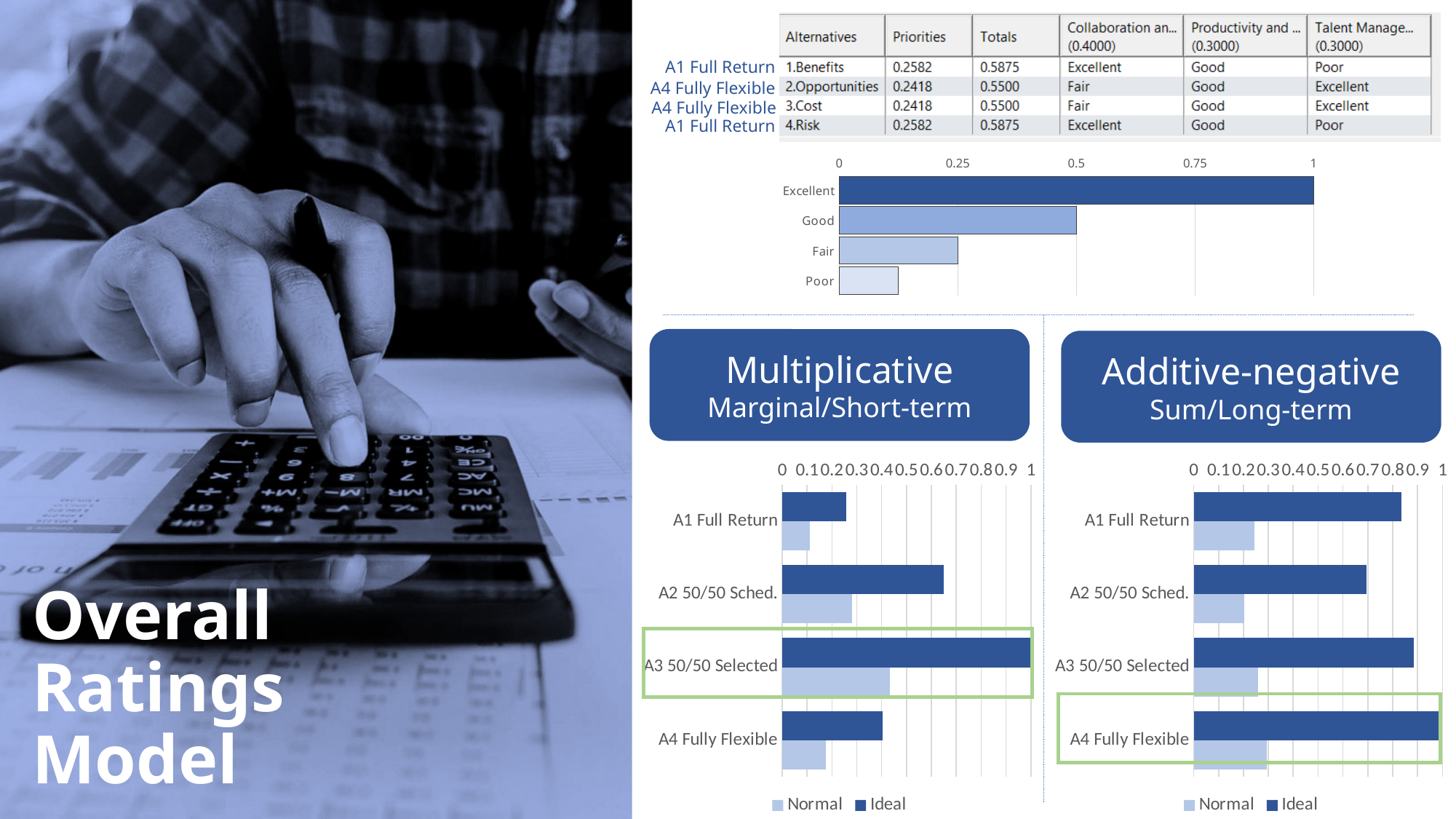
In the top-right chart with the categories Excellent, Good, Fair and Poor, which category has the highest value? Excellent In the Multiplicative chart, which alternative has the highest Ideal value? A3 50/50 Selected In the Additive-negative chart, what are the two series named in the legend? Normal and Ideal In the top-right chart with the categories Excellent, Good, Fair and Poor, is the value for Poor greater or less than 0.25? less In the Multiplicative chart, is the Ideal value for A2 50/50 Sched. greater or less than 0.5? greater In the Additive-negative chart, which alternative has the lowest Ideal value? A2 50/50 Sched. In the Additive-negative chart, which alternative has the highest Ideal value? A4 Fully Flexible In the Multiplicative chart, how many series does the legend list? 2 In the top-right chart with the categories Excellent, Good, Fair and Poor, how many categories are plotted? 4 In the Multiplicative chart, which alternative has the lowest Ideal value? A1 Full Return In the top-right chart with the categories Excellent, Good, Fair and Poor, what is the value for Excellent? 1 What kind of chart is the chart at the top right with the categories Excellent, Good, Fair and Poor? bar chart